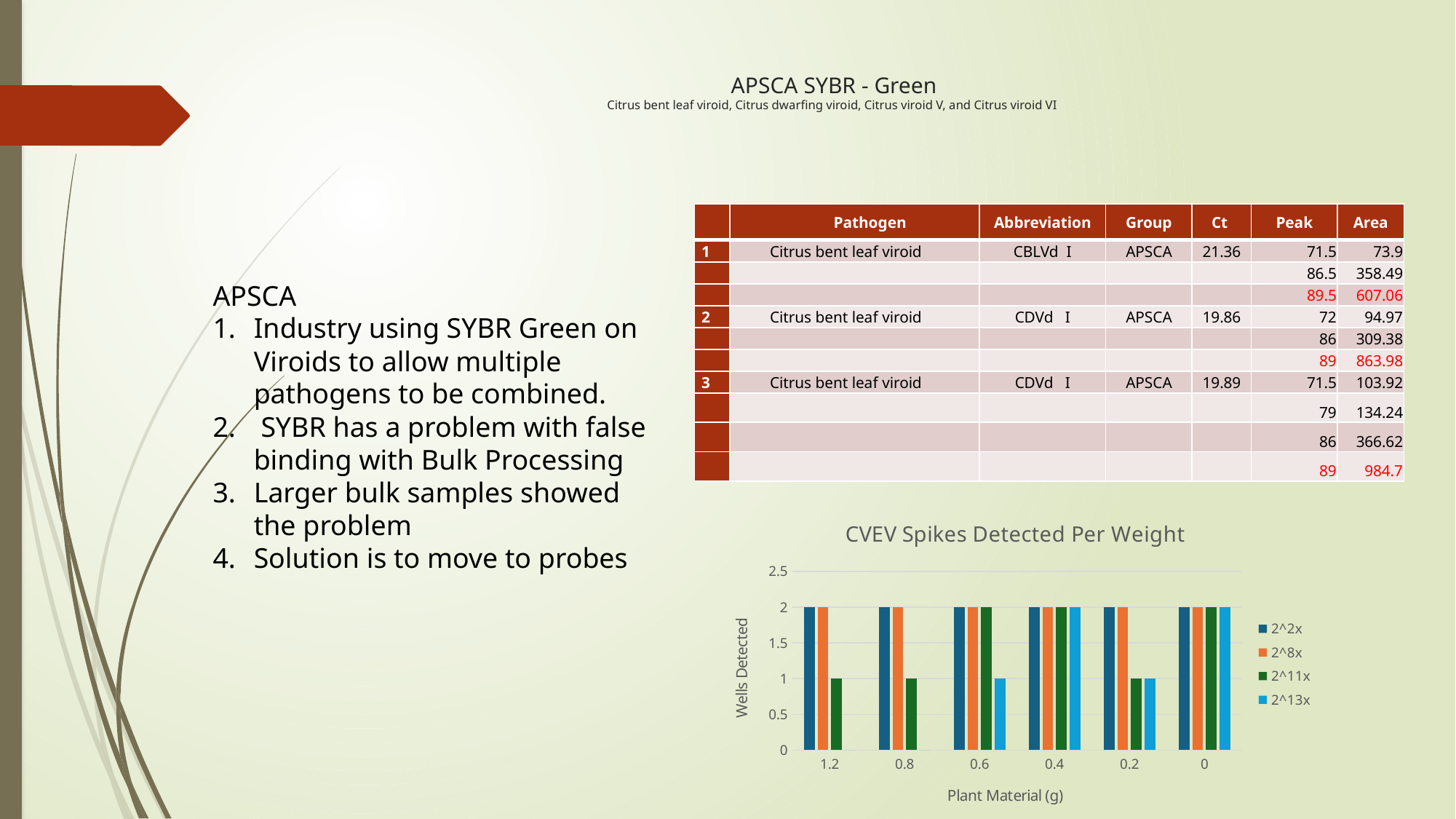
How many wells were detected for the 2^13x series at 0 g of plant material? 2 What is the label of the y axis of the chart? Wells Detected How many wells were detected for the 2^2x series at 0.4 g of plant material? 2 What is the difference between the 2^2x value and the 2^13x value at 0.6 g of plant material? 1 How many series does the chart legend list? 4 What kind of chart is shown on the slide? bar chart What is the title of the chart? CVEV Spikes Detected Per Weight How many wells were detected for the 2^13x series at 0.6 g of plant material? 1 Is the value for the 2^8x series at 0.8 g greater or less than 1.5? greater How many wells were detected for the 2^11x series at 1.2 g of plant material? 1 How many plant material categories are shown on the x axis of the chart? 6 Which is larger at 0.2 g of plant material: the 2^8x series or the 2^11x series? 2^8x